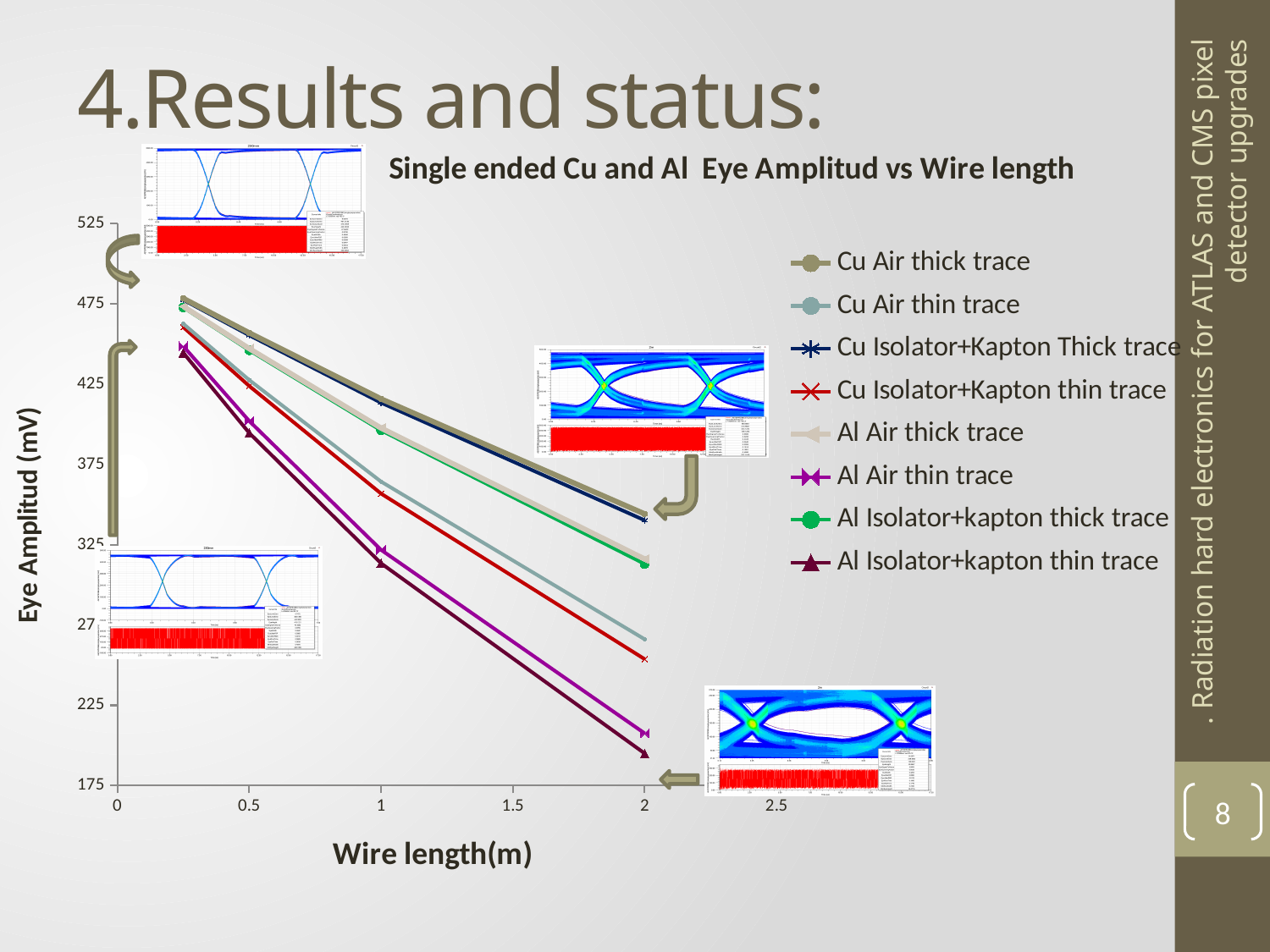
What kind of chart is shown on the slide? line chart Do the eye amplitude values rise or fall as wire length increases? fall Is the value for Al Air thin trace at 2 m greater or less than 225? less How many series does the legend list? 8 Which series has the lowest value at 2 m wire length? Al Isolator+kapton thin trace Is the value for Cu Isolator+Kapton thin trace at 2 m greater or less than 275? less What is the title of the chart? Single ended Cu and Al Eye Amplitud vs Wire length What is the label of the x axis? Wire length(m) Is the value for Cu Air thick trace at 2 m greater or less than 325? greater At 2 m wire length, which is larger: Cu Air thick trace or Al Isolator+kapton thin trace? Cu Air thick trace At 2 m wire length, which is larger: Cu Isolator+Kapton thin trace or Al Air thin trace? Cu Isolator+Kapton thin trace